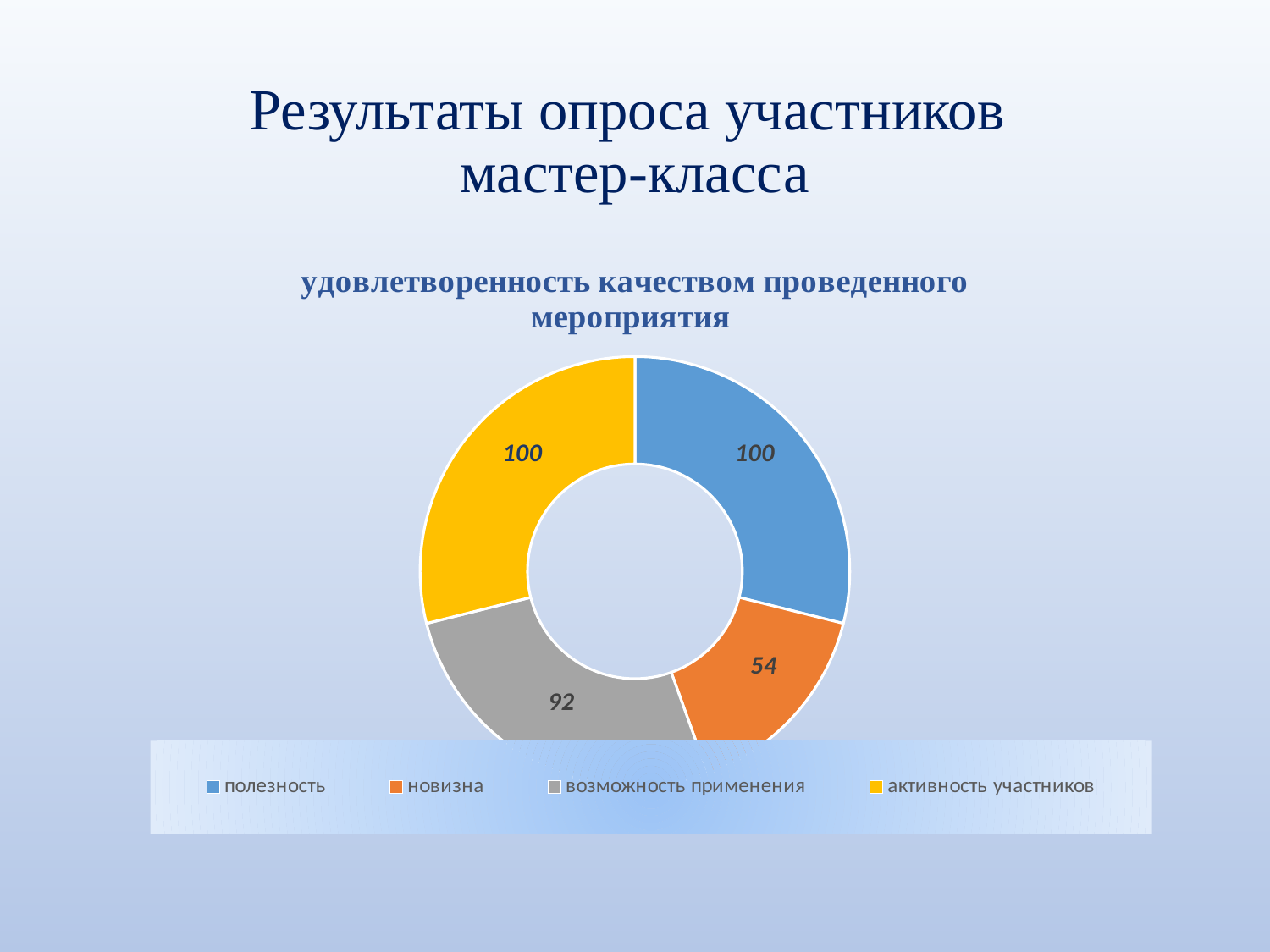
How many categories does the chart show? 4 What value is shown for новизна? 54 Which is larger, the value for возможность применения or the value for новизна? возможность применения Which colour represents активность участников in the chart? yellow What value is shown for полезность? 100 What kind of chart is shown on the slide? doughnut chart What is the title of the chart? удовлетворенность качеством проведенного мероприятия What is the difference between the values for полезность and новизна? 46 Which category has the lowest value? новизна What is the difference between the values for возможность применения and новизна? 38 What value is shown for активность участников? 100 What value is shown for возможность применения? 92